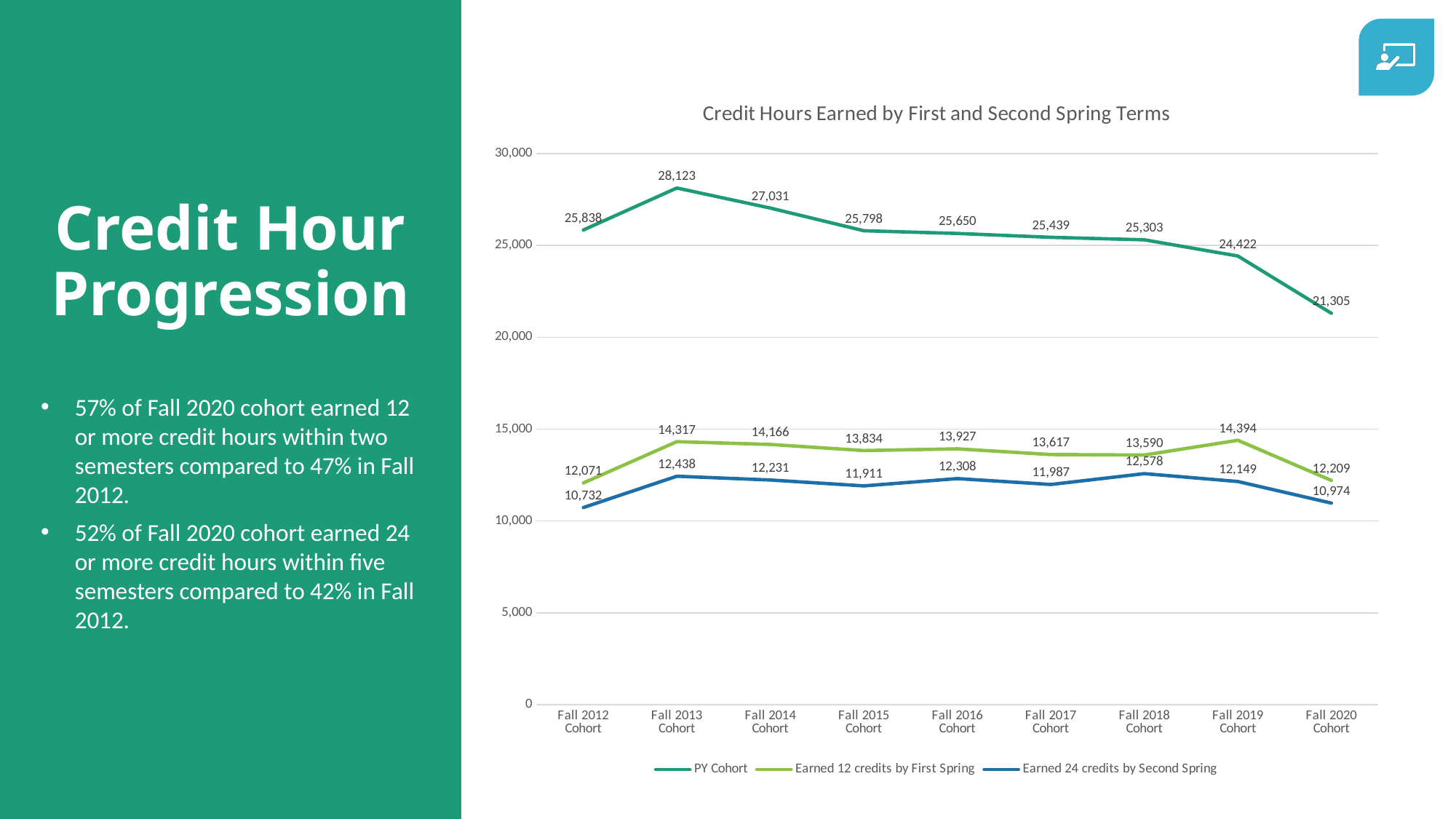
Is the PY Cohort value for the Fall 2020 Cohort greater or less than 25,000? less What is the value of Earned 12 credits by First Spring for the Fall 2019 Cohort? 14,394 What is the title of the chart? Credit Hours Earned by First and Second Spring Terms Which cohort has the highest PY Cohort value? Fall 2013 Cohort What is the difference between the PY Cohort value and the Earned 12 credits by First Spring value for the Fall 2020 Cohort? 9,096 What kind of chart is shown on the slide? line chart How many series does the legend list? 3 How many cohorts are shown on the x axis? 9 What is the value of Earned 24 credits by Second Spring for the Fall 2012 Cohort? 10,732 Which is larger for the Fall 2018 Cohort: Earned 12 credits by First Spring or Earned 24 credits by Second Spring? Earned 12 credits by First Spring Which cohort has the lowest value for Earned 24 credits by Second Spring? Fall 2012 Cohort What is the PY Cohort value for the Fall 2013 Cohort? 28,123